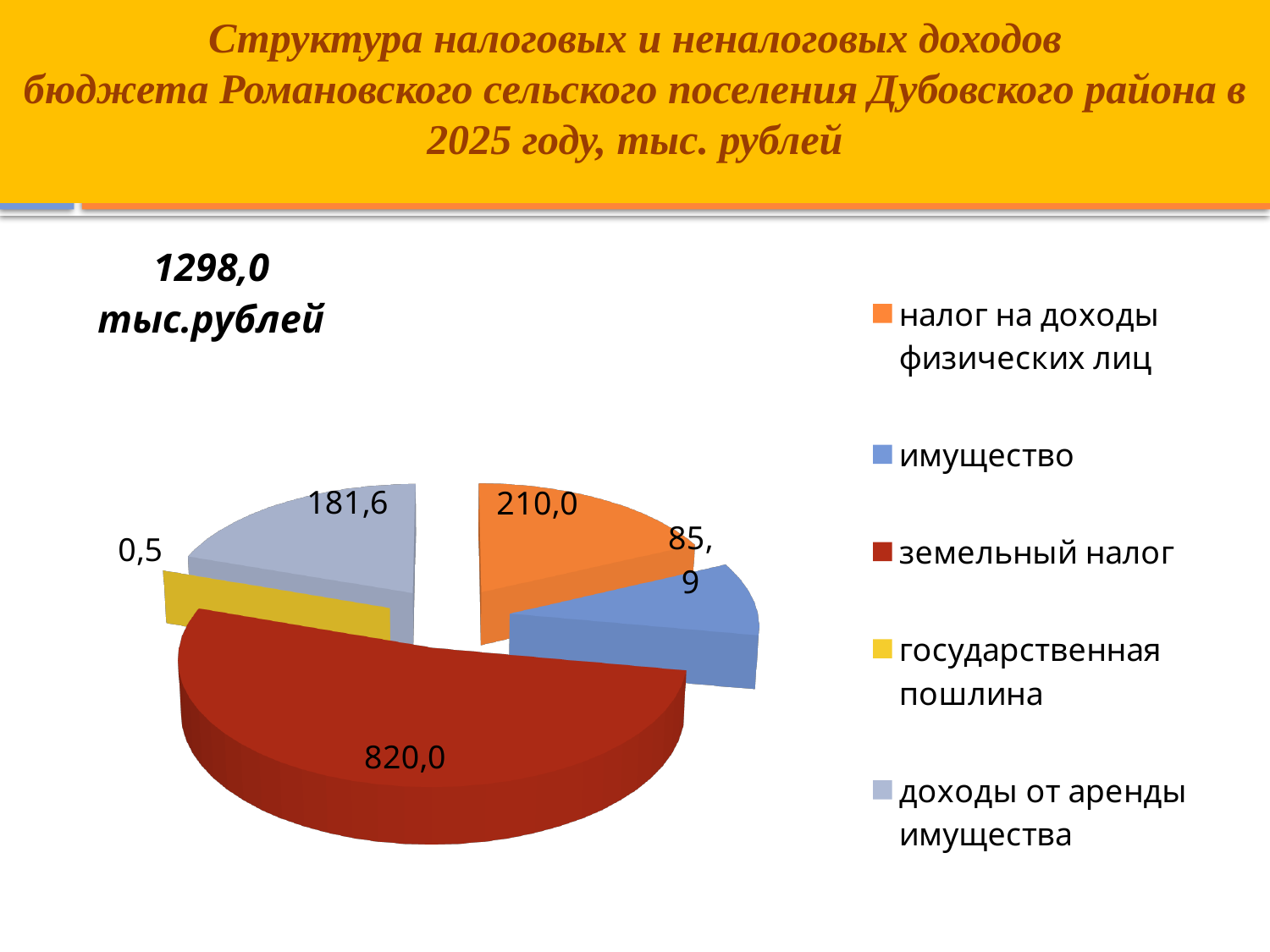
Which category has the largest slice of the pie? земельный налог What value is shown for земельный налог on the pie chart? 820,0 Which category has the smallest slice of the pie? государственная пошлина Which is larger: the value for имущество or the value for доходы от аренды имущества? доходы от аренды имущества What total amount is stated on the slide for all the revenues in the pie chart? 1298,0 тыс.рублей What value is shown for налог на доходы физических лиц? 210,0 How many categories does the pie chart show? 5 What is the difference between the values for налог на доходы физических лиц and доходы от аренды имущества? 28,4 What kind of chart is shown on the slide? pie chart What is the difference between the values for земельный налог and налог на доходы физических лиц? 610,0 What value is shown for доходы от аренды имущества? 181,6 What value is shown for имущество? 85,9